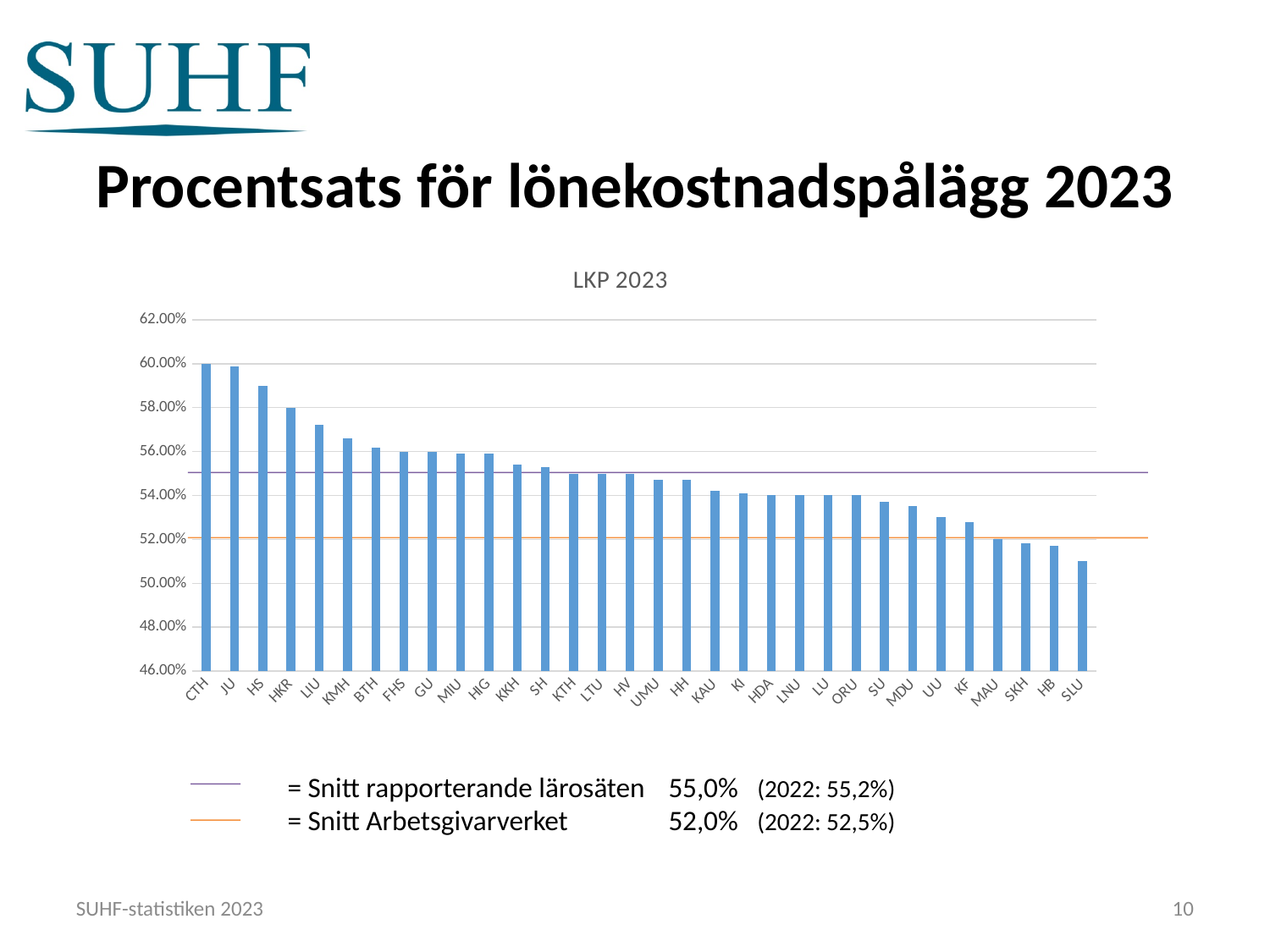
Is the value for SLU greater or less than 52.00%? less How many institutions (bars) are shown in the chart? 32 Is the value for LIU greater or less than 56.00%? greater Which is larger, the value for HS or the value for HKR? HS Is the value for HS greater or less than 58.00%? greater What is the value of the 'Snitt Arbetsgivarverket' average line for 2023? 52,0% Do the values rise or fall from left to right along the x axis? fall What is the value of the 'Snitt rapporterande lärosäten' average line for 2023? 55,0% Which institution has the lowest value in the chart? SLU What is the title of the chart? LKP 2023 What kind of chart is shown on the slide? bar chart